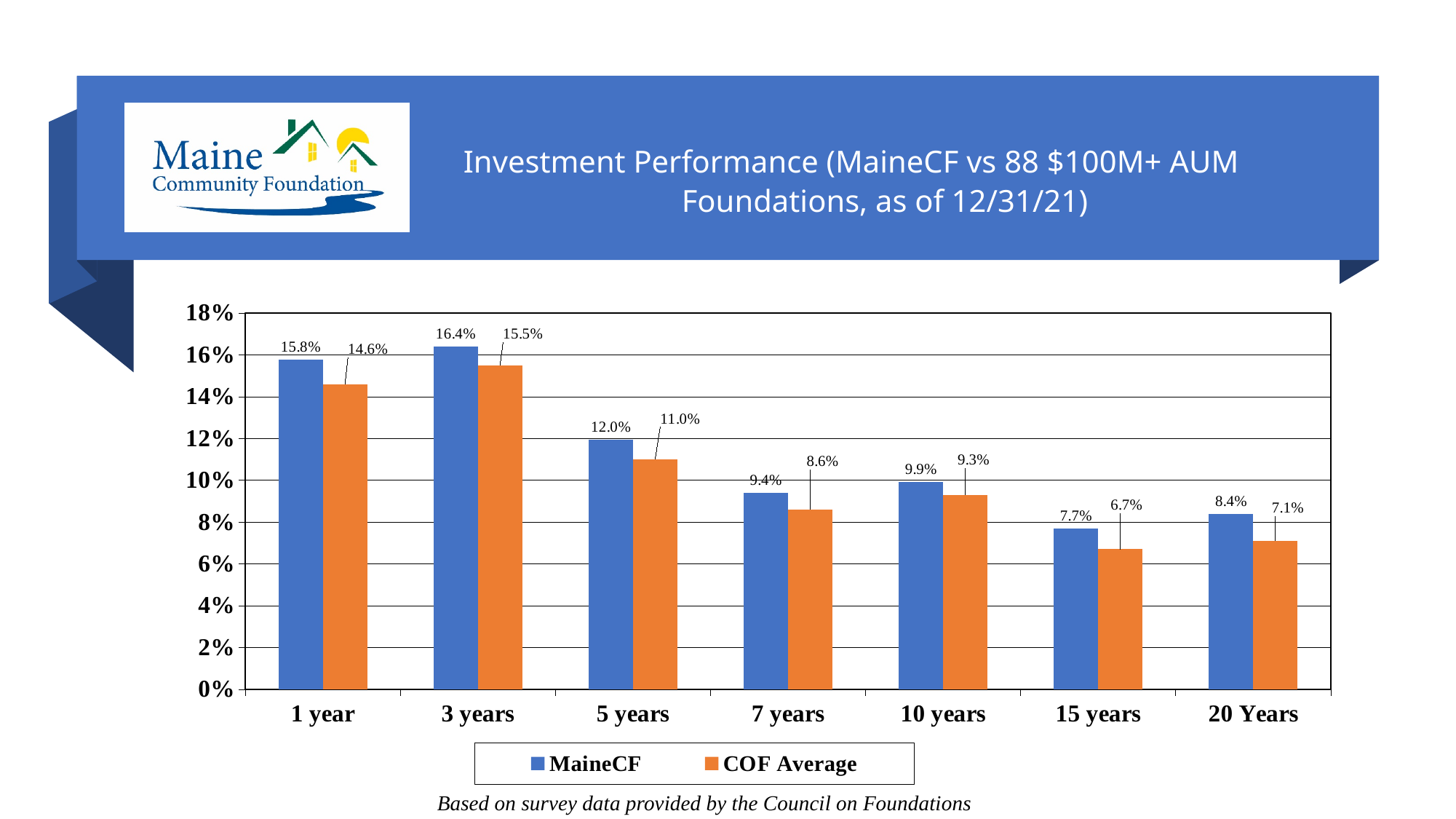
What is the difference between the MaineCF and COF Average values for 1 year? 1.2% Which period has the lowest COF Average value? 15 years Which colour represents COF Average in the chart? Orange What is the MaineCF value for 20 Years? 8.4% How many time periods are shown on the x axis? 7 What is the COF Average value for 15 years? 6.7% What is the difference between the MaineCF and COF Average values for 20 Years? 1.3% How many series does the legend list? 2 Which is larger for 10 years, MaineCF or COF Average? MaineCF Which period has the highest MaineCF value? 3 years What is the MaineCF value for 3 years? 16.4% What kind of chart is shown on the slide? Bar chart